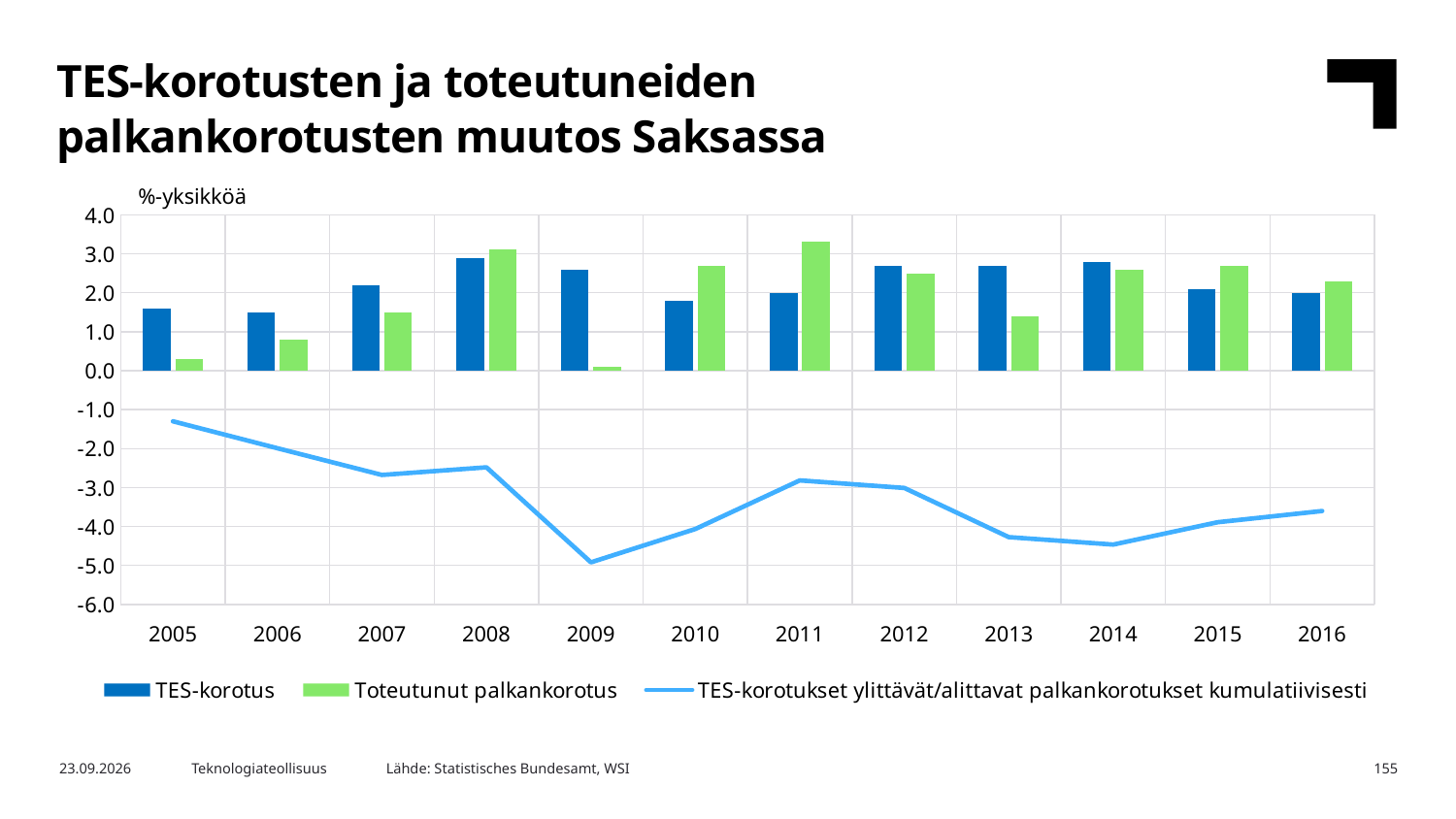
In which year is the Toteutunut palkankorotus bar the lowest? 2009 In which year is the Toteutunut palkankorotus bar the highest? 2011 Is the Toteutunut palkankorotus value for 2011 greater or less than 3.0? greater In 2009, which is larger: the TES-korotus bar or the Toteutunut palkankorotus bar? TES-korotus In 2010, which is larger: the TES-korotus bar or the Toteutunut palkankorotus bar? Toteutunut palkankorotus How many series does the chart's legend list? 3 What kind of chart is shown on the slide? A bar chart combined with a line Is the value of the cumulative line for 2009 greater or less than -4.0? less In which year does the line 'TES-korotukset ylittävät/alittavat palkankorotukset kumulatiivisesti' reach its lowest point? 2009 How many years are shown on the x axis of the chart? 12 Is the Toteutunut palkankorotus value for 2005 greater or less than 1.0? less Does the cumulative line rise or fall from 2005 to 2009? fall